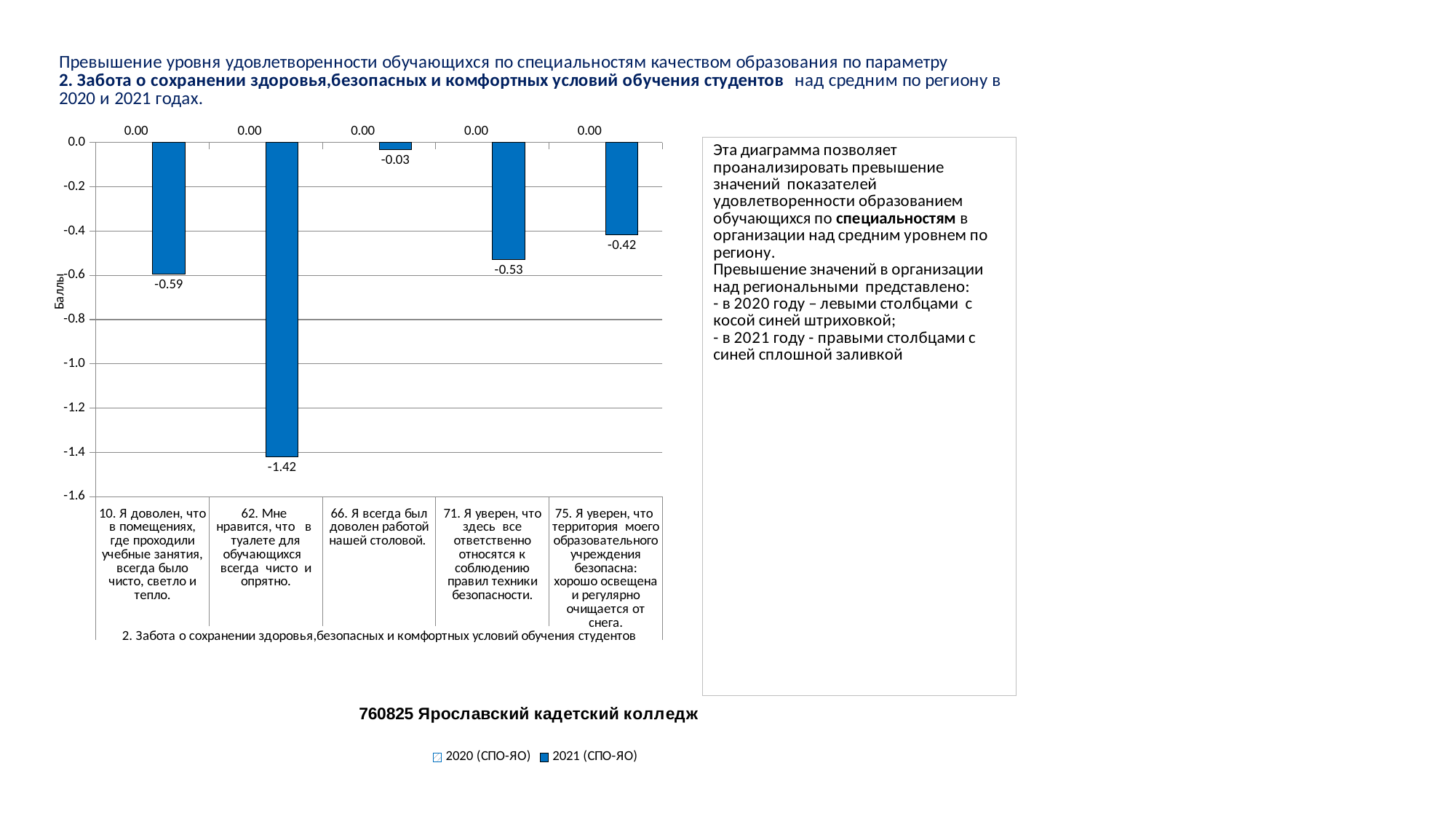
What is the 2021 (СПО-ЯО) value for category 62 (Мне нравится, что в туалете для обучающихся всегда чисто и опрятно)? -1.42 How many categories are shown on the x axis of the chart? 5 What is the 2021 (СПО-ЯО) value for category 66 (Я всегда был доволен работой нашей столовой)? -0.03 What type of chart is shown on the slide? Bar chart Which category has the lowest 2021 (СПО-ЯО) value? 62. Мне нравится, что в туалете для обучающихся всегда чисто и опрятно. How many series does the chart legend list? 2 Which category has the highest 2021 (СПО-ЯО) value? 66. Я всегда был доволен работой нашей столовой. Which is larger, the 2021 (СПО-ЯО) value for category 71 or for category 75? 75. Я уверен, что территория моего образовательного учреждения безопасна (-0.42) What is the difference between the 2021 (СПО-ЯО) values for category 10 and category 71? 0.06 What is the 2020 (СПО-ЯО) value for category 75 (Я уверен, что территория моего образовательного учреждения безопасна)? 0.00 What is the 2021 (СПО-ЯО) value for category 10 (Я доволен, что в помещениях, где проходили учебные занятия, всегда было чисто, светло и тепло)? -0.59 What is the label of the y axis of the chart? Баллы